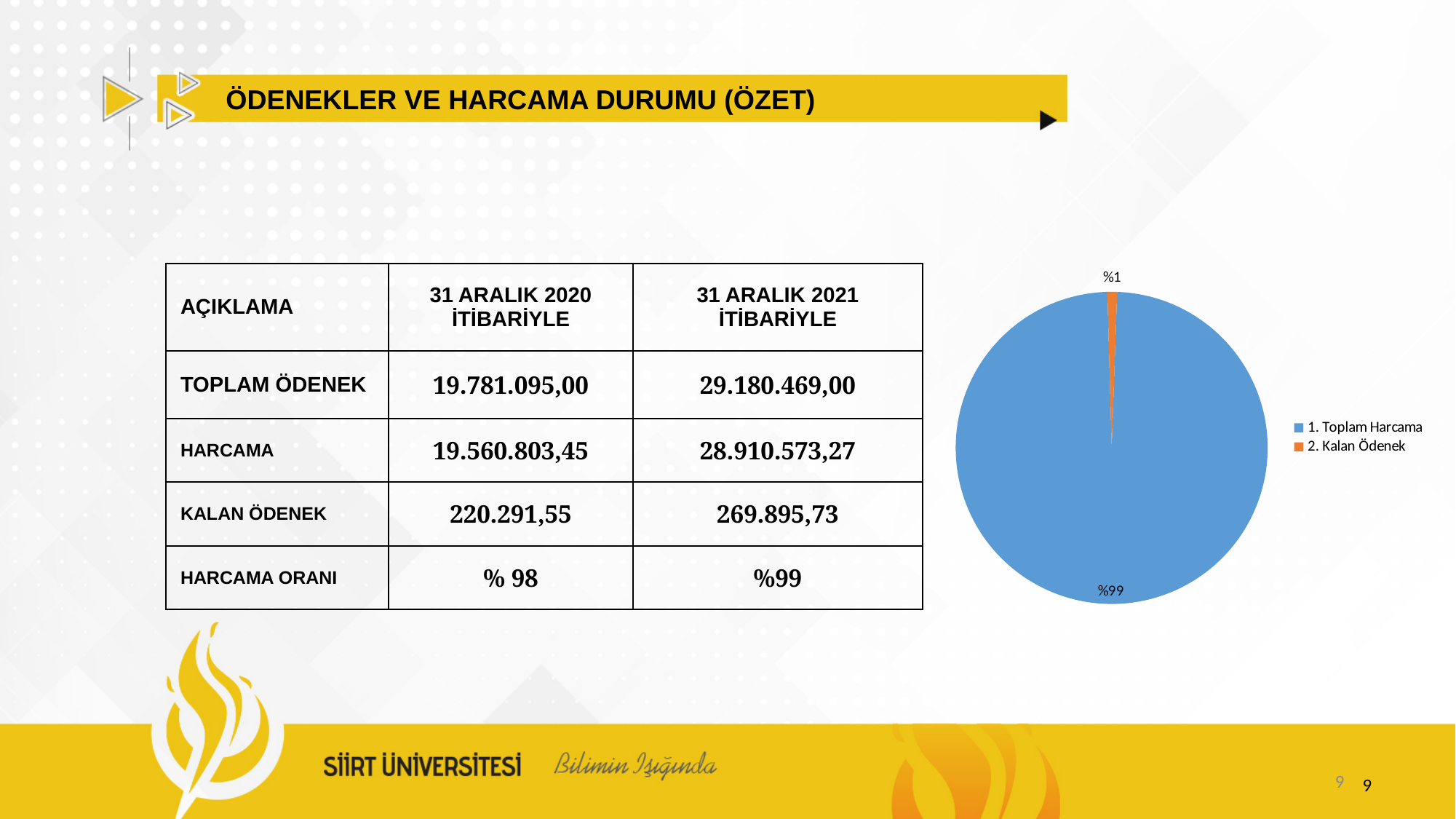
How many slices does the pie chart have? 2 Which slice of the pie chart is the smallest? 2. Kalan Ödenek What share of the pie does "2. Kalan Ödenek" take? %1 What share of the pie does "1. Toplam Harcama" take? %99 What kind of chart is shown on the slide? pie chart What colour is the "2. Kalan Ödenek" slice in the pie chart? orange Which is larger in the pie chart, "1. Toplam Harcama" or "2. Kalan Ödenek"? 1. Toplam Harcama What is the difference in percentage points between the "1. Toplam Harcama" slice and the "2. Kalan Ödenek" slice? 98 Which slice of the pie chart is the largest? 1. Toplam Harcama How many entries does the pie chart's legend list? 2 What colour is the "1. Toplam Harcama" slice in the pie chart? blue